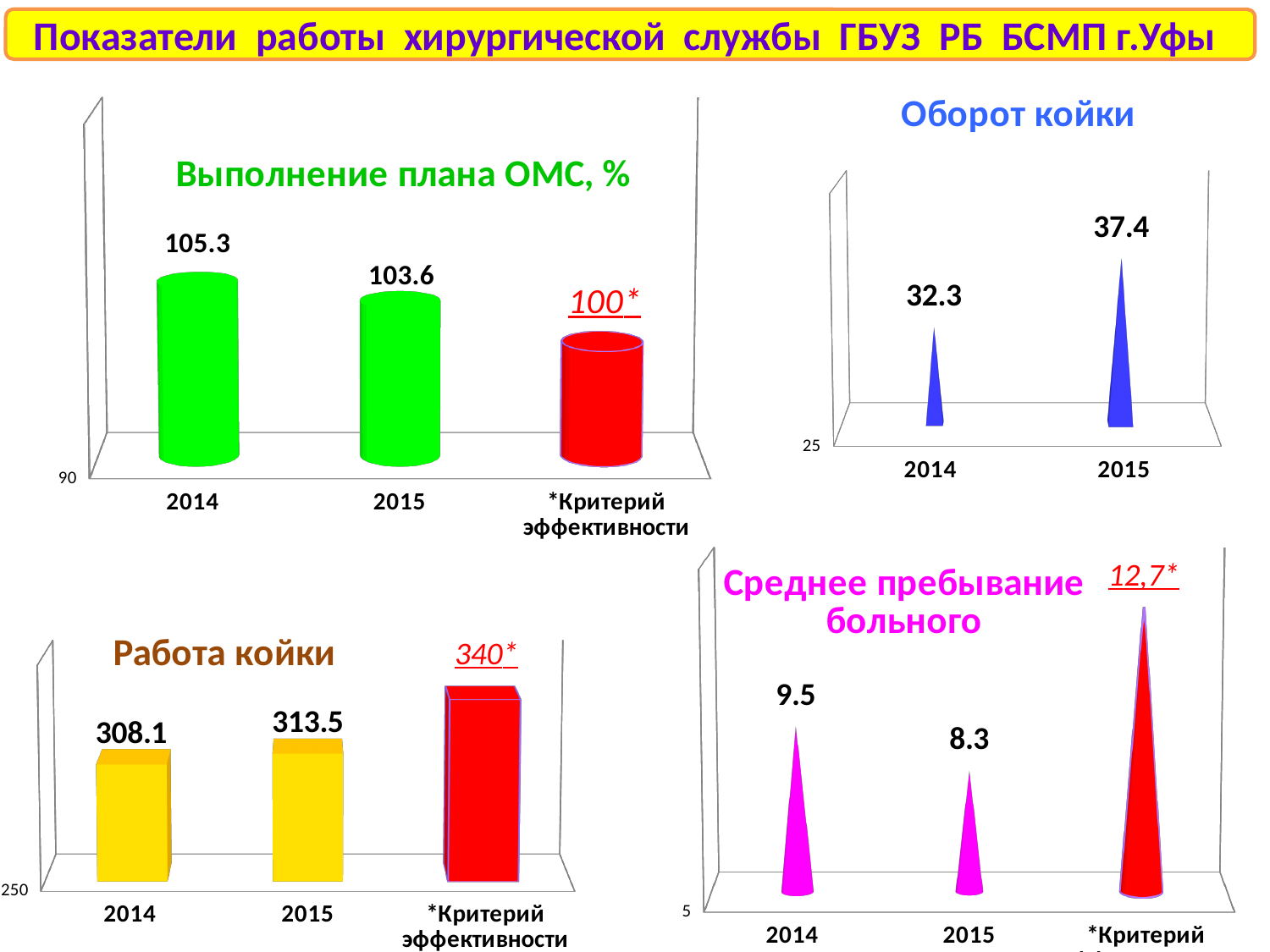
In the chart titled "Выполнение плана ОМС, %", what is the value for 2015? 103.6 How many categories are shown in the chart titled "Оборот койки"? 2 In the chart titled "Среднее пребывание больного", which category has the lowest value? 2015 In the chart titled "Оборот койки", what is the value for 2015? 37.4 In the chart titled "Работа койки", what is the difference between the 2015 and 2014 values? 5.4 In the chart titled "Оборот койки", what is the difference between the 2015 and 2014 values? 5.1 In the chart titled "Работа койки", what is the value for 2014? 308.1 In the chart titled "Выполнение плана ОМС, %", what is the value labelled for "*Критерий эффективности"? 100* In the chart titled "Оборот койки", which year has the higher value, 2014 or 2015? 2015 In the chart titled "Работа койки", which category has the highest value? *Критерий эффективности In the chart titled "Среднее пребывание больного", what is the value for 2015? 8.3 In the chart titled "Выполнение плана ОМС, %", what is the value for 2014? 105.3